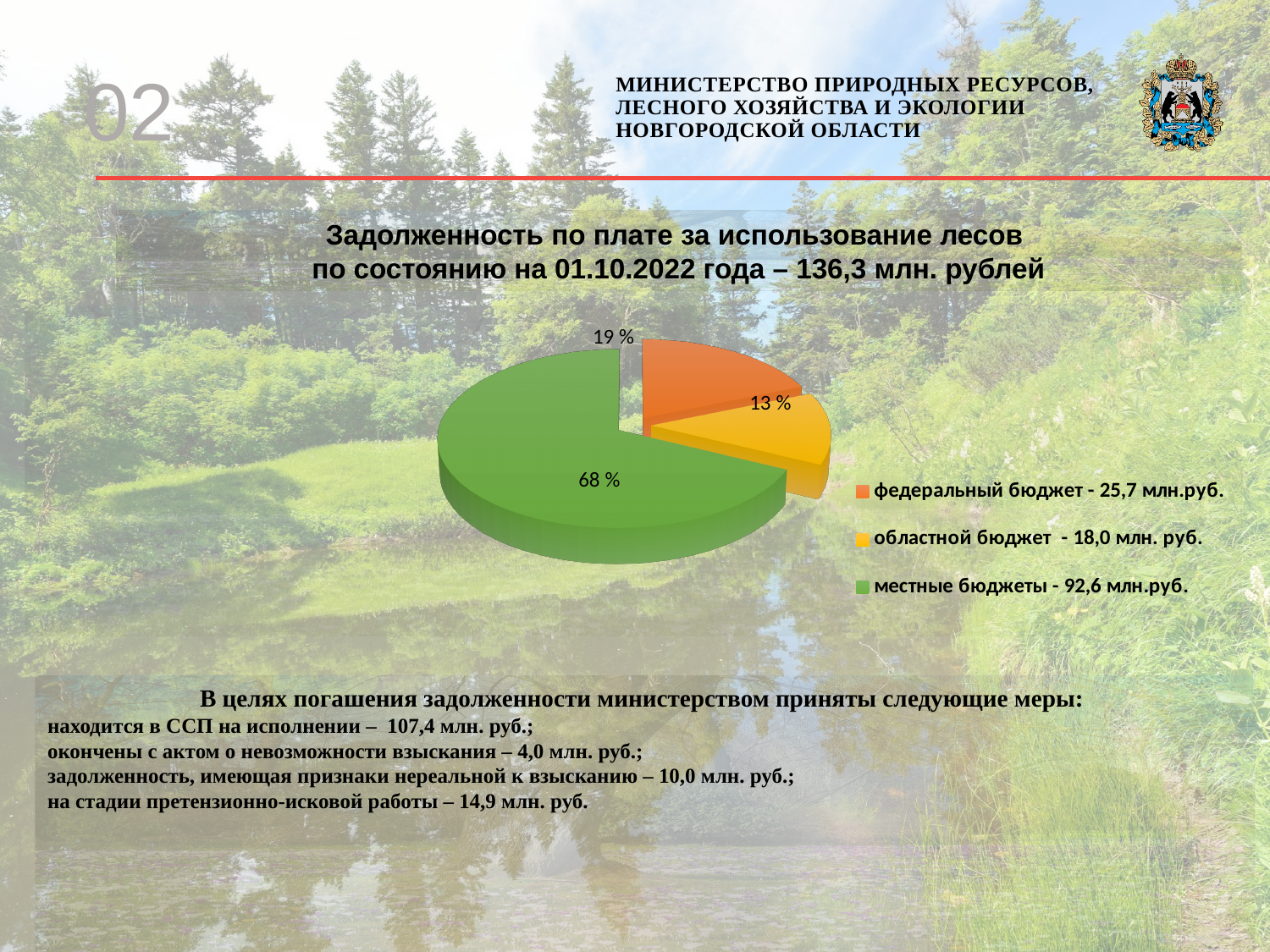
What kind of chart is shown on the slide? pie chart What share of the pie does the slice for федеральный бюджет represent? 19 % Which category has the smallest slice of the pie? областной бюджет How many entries does the legend list? 3 What share of the pie does the slice for местные бюджеты represent? 68 % What is the difference in percentage points between the местные бюджеты slice and the федеральный бюджет slice? 49 % Which category has the largest slice of the pie? местные бюджеты Which slice is larger: федеральный бюджет or областной бюджет? федеральный бюджет According to the legend, what amount in млн. руб. corresponds to местные бюджеты? 92,6 млн.руб. What share of the pie does the slice for областной бюджет represent? 13 % How many slices does the pie chart have? 3 What colour is the slice for областной бюджет? yellow